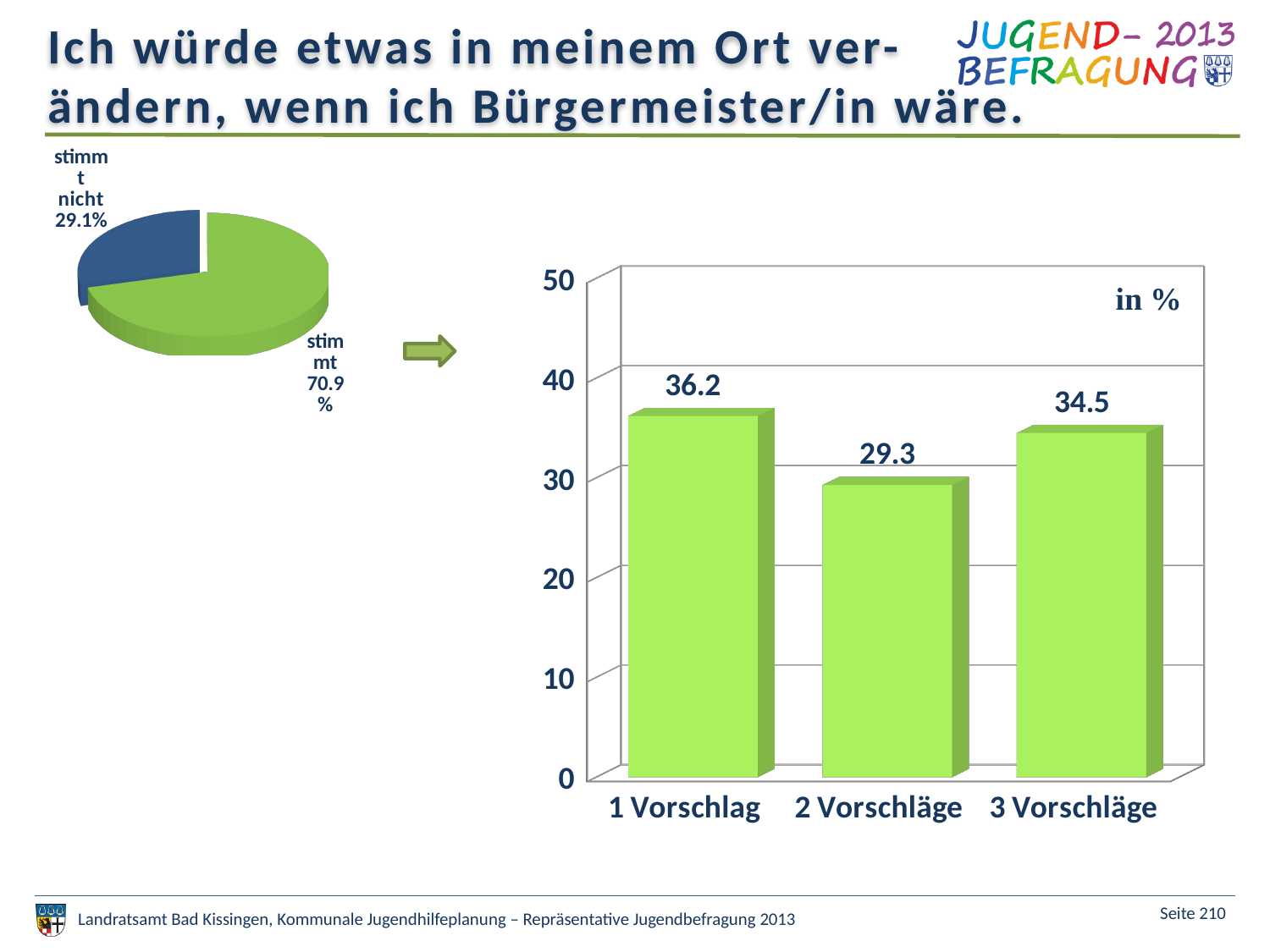
In the bar chart on the right, which category has the highest value? 1 Vorschlag In the pie chart on the left, which slice is larger, "stimmt" or "stimmt nicht"? stimmt In the bar chart on the right, what is the value for "1 Vorschlag"? 36.2 In the bar chart on the right, which category has the lowest value? 2 Vorschläge What kind of chart is shown on the left of the slide? Pie chart In the bar chart on the right, what is the value for "3 Vorschläge"? 34.5 In the bar chart on the right, what is the value for "2 Vorschläge"? 29.3 In the pie chart on the left, how many slices are there? 2 What kind of chart is shown on the right of the slide? Bar chart In the bar chart on the right, what is the difference between the values for "1 Vorschlag" and "2 Vorschläge"? 6.9 In the pie chart on the left, what share is labelled "stimmt"? 70.9% In the pie chart on the left, what share is labelled "stimmt nicht"? 29.1%